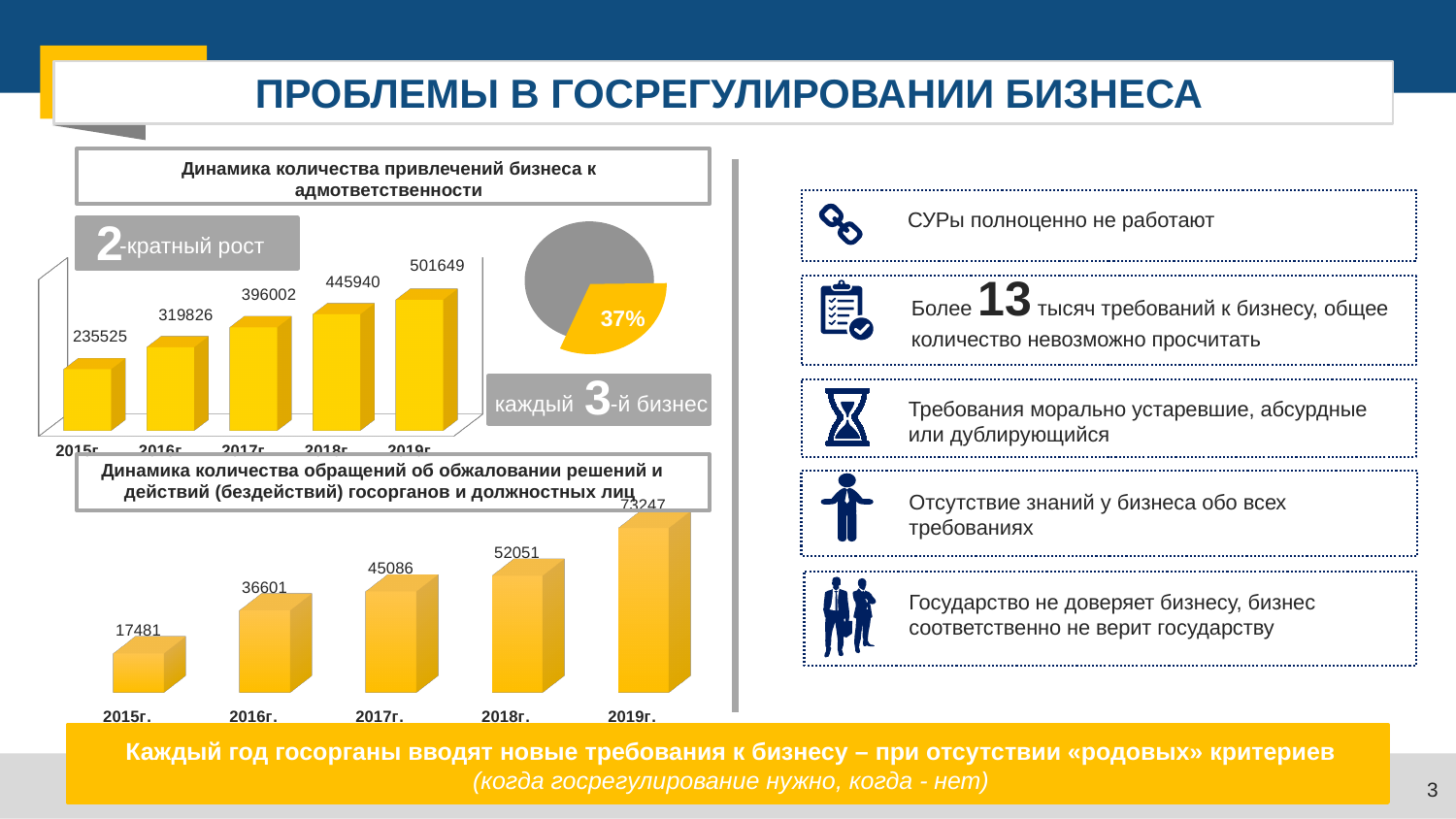
What kind of chart is the bottom chart 'Динамика количества обращений об обжаловании решений и действий (бездействий) госорганов и должностных лиц'? bar chart In the top chart 'Динамика количества привлечений бизнеса к адмответственности', what is the value for 2015г.? 235525 In the bottom chart 'Динамика количества обращений об обжаловании решений и действий (бездействий) госорганов и должностных лиц', which year has the lowest value? 2015г. In the top chart 'Динамика количества привлечений бизнеса к адмответственности', what is the value for 2019г.? 501649 In the top chart 'Динамика количества привлечений бизнеса к адмответственности', do the values rise or fall from 2015г. to 2019г.? rise In the bottom chart 'Динамика количества обращений об обжаловании решений и действий (бездействий) госорганов и должностных лиц', what is the value for 2017г.? 45086 In the bottom chart 'Динамика количества обращений об обжаловании решений и действий (бездействий) госорганов и должностных лиц', which is larger: the value for 2016г. or 2017г.? 2017г. In the top chart 'Динамика количества привлечений бизнеса к адмответственности', which year has the highest value? 2019г. In the pie chart at the top right of the left panel, what share is shown for the yellow slice? 37% In the top chart 'Динамика количества привлечений бизнеса к адмответственности', what is the difference between the 2019г. and 2015г. values? 266124 How many years (categories) are shown in the bottom chart 'Динамика количества обращений об обжаловании решений и действий (бездействий) госорганов и должностных лиц'? 5 In the bottom chart 'Динамика количества обращений об обжаловании решений и действий (бездействий) госорганов и должностных лиц', what is the difference between the 2019г. and 2018г. values? 21196